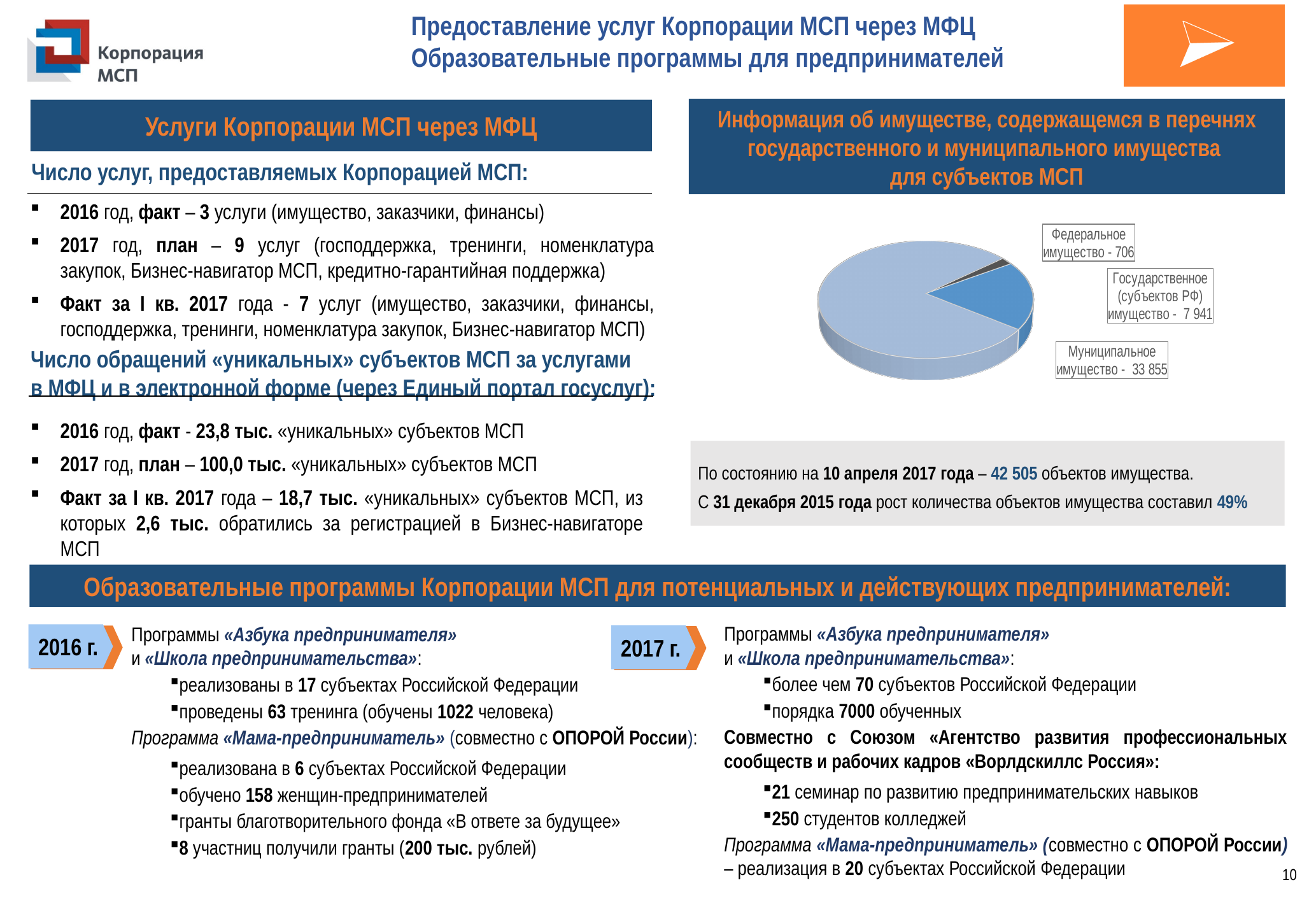
What is the value for Федеральное имущество in the pie chart? 706 What is the difference between Государственное (субъектов РФ) имущество and Федеральное имущество in the pie chart? 7 235 What is the value for Муниципальное имущество in the pie chart? 33 855 Which is larger in the pie chart: Государственное (субъектов РФ) имущество or Федеральное имущество? Государственное (субъектов РФ) имущество What is the total of the three values shown in the pie chart? 42 502 What is the value for Государственное (субъектов РФ) имущество in the pie chart? 7 941 What is the difference between Муниципальное имущество and Государственное (субъектов РФ) имущество in the pie chart? 25 914 What is the title of the section containing the pie chart? Информация об имуществе, содержащемся в перечнях государственного и муниципального имущества для субъектов МСП Which category has the largest slice in the pie chart? Муниципальное имущество What kind of chart is shown on the slide? pie chart Which category has the smallest slice in the pie chart? Федеральное имущество How many slices does the pie chart have? 3